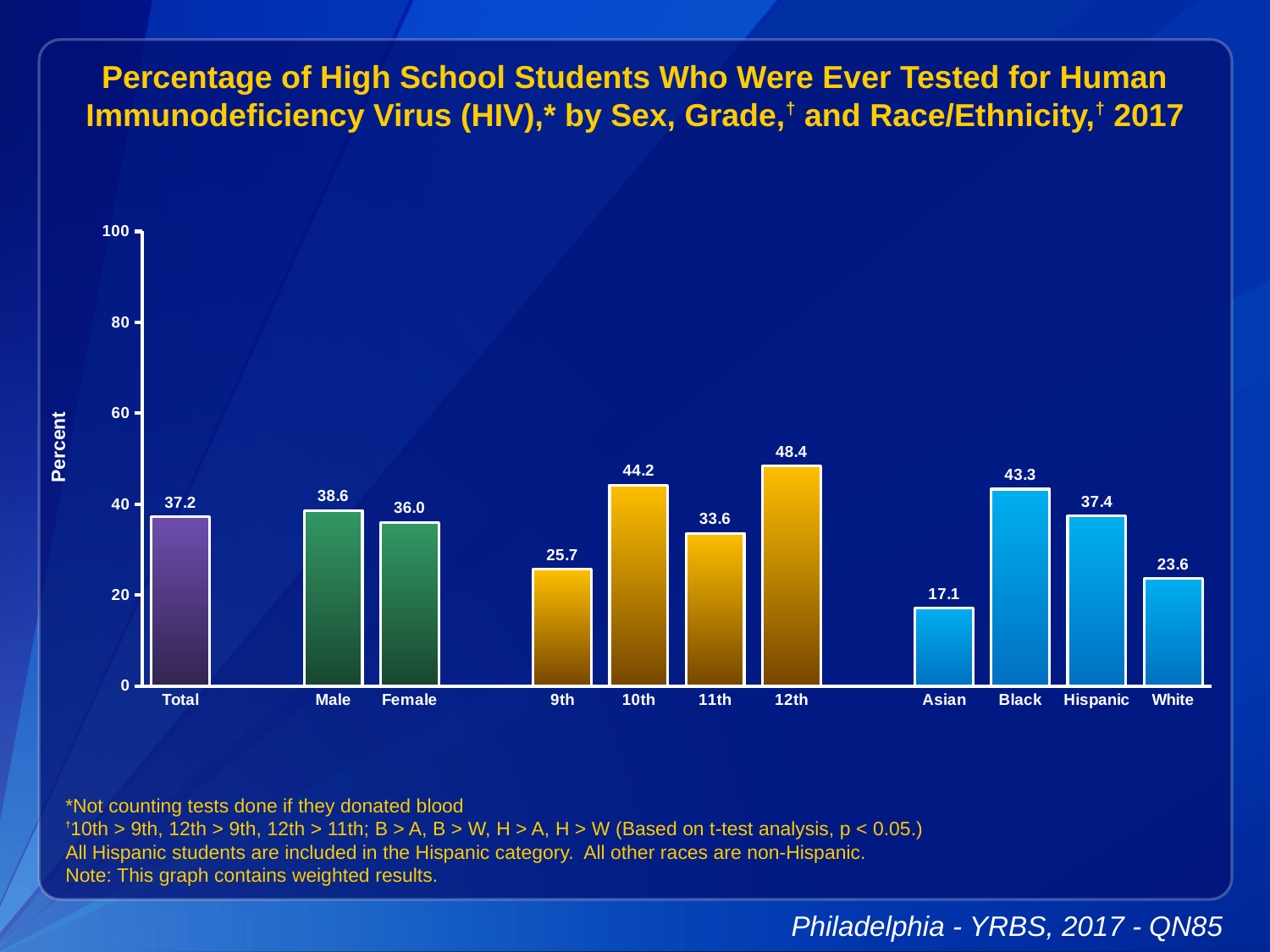
Which is larger, the value for 10th grade or 11th grade? 10th What is the value for 12th grade? 48.4 What is the difference between the values for Black and White? 19.7 What is the value for Total? 37.2 What is the difference between the values for Male and Female? 2.6 Which category has the lowest value? Asian How many bars are shown in the chart? 11 What is the value for Asian students? 17.1 Which category has the highest value? 12th What kind of chart is shown on the slide? bar chart What is the label on the vertical axis? Percent Is the value for 9th grade greater or less than 20? greater